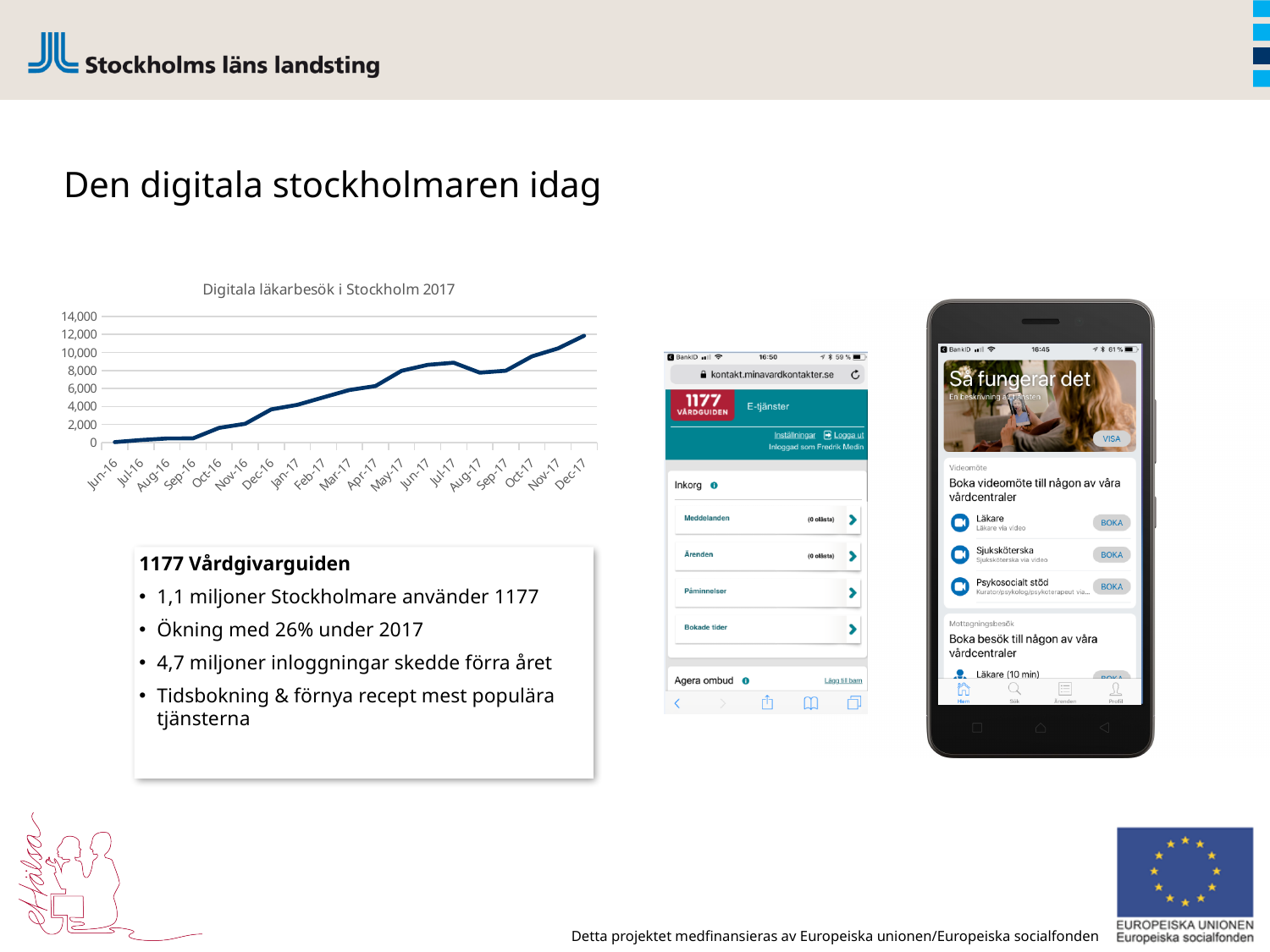
Which month has the lowest value in the chart? Jun-16 What type of chart is shown on the slide? Line chart Is the value for Dec-17 greater or less than 10,000? greater Which month has the highest value in the chart? Dec-17 Is the value for Mar-17 greater or less than 4,000? greater How many months are plotted along the x axis of the chart? 19 Which is larger, the value for Mar-17 or the value for Sep-16? Mar-17 Is the value for Jun-16 greater or less than 2,000? less What is the title of the chart on the slide? Digitala läkarbesök i Stockholm 2017 Do the values in the chart generally rise or fall from Jun-16 to Dec-17? Rise What is the highest value shown on the y axis of the chart? 14,000